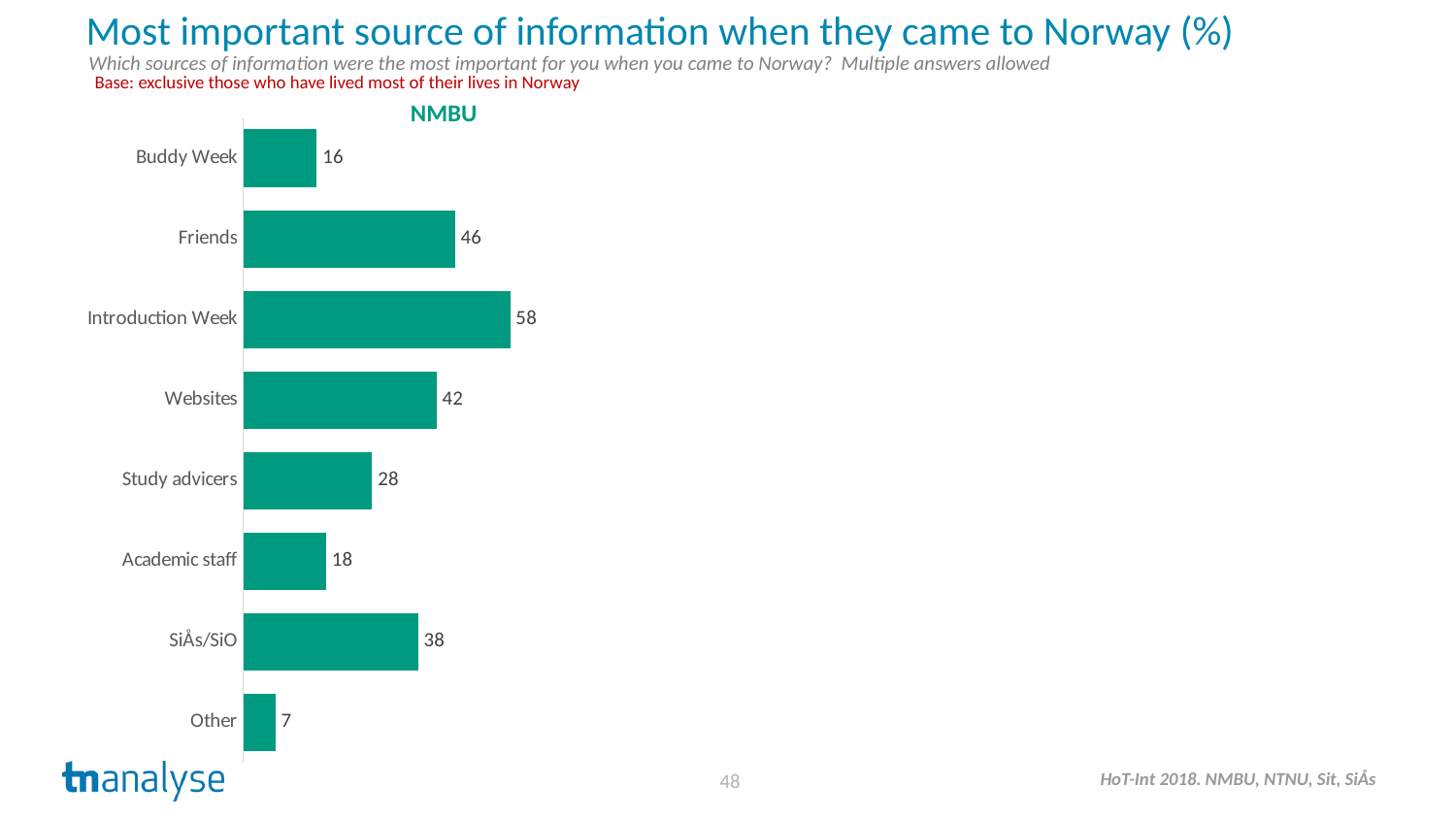
Which category has the lowest value? Other What is the difference between the values for Study advicers and Academic staff? 10 What is the difference between the values for Introduction Week and Websites? 16 How many categories are shown in the chart? 8 What is the value for Other? 7 What is the title shown above the chart? NMBU Which is larger, the value for Friends or the value for Websites? Friends What is the value for SiÅs/SiO? 38 Which category has the highest value? Introduction Week What is the value for Friends? 46 What kind of chart is shown on the slide? Bar chart What is the value for Introduction Week? 58